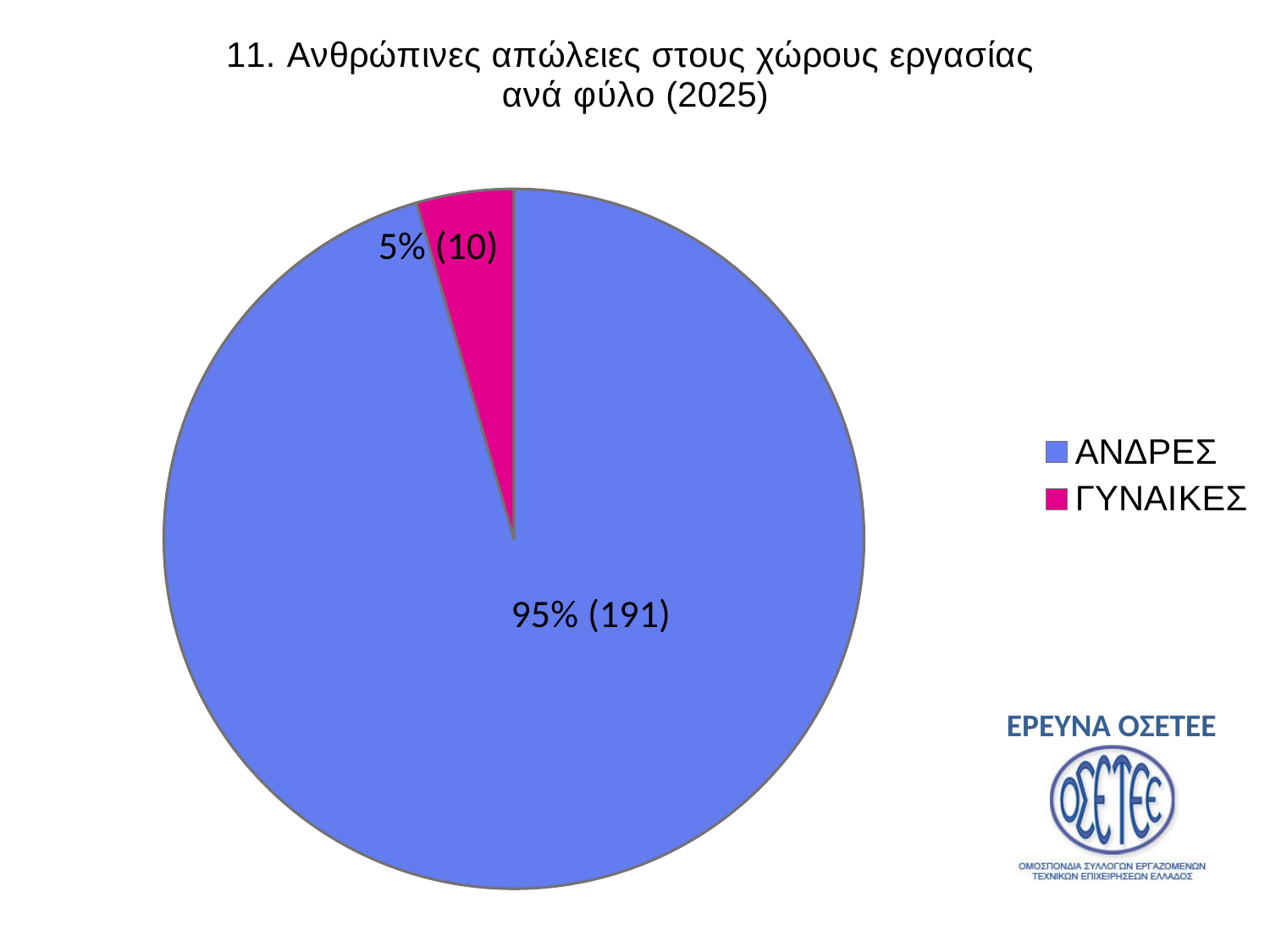
What colour is the slice for ΓΥΝΑΙΚΕΣ? magenta (pink) What share of the pie does ΑΝΔΡΕΣ represent? 95% What is the total of the counts shown on the pie chart? 201 How many categories does the pie chart have? 2 What is the count shown for ΓΥΝΑΙΚΕΣ? 10 What share of the pie does ΓΥΝΑΙΚΕΣ represent? 5% What is the difference between the counts for ΑΝΔΡΕΣ and ΓΥΝΑΙΚΕΣ? 181 Which category has the smallest slice of the pie? ΓΥΝΑΙΚΕΣ What kind of chart is shown on the slide? pie chart What is the count shown for ΑΝΔΡΕΣ? 191 Which category has the largest slice of the pie? ΑΝΔΡΕΣ Which is larger, the count for ΑΝΔΡΕΣ or the count for ΓΥΝΑΙΚΕΣ? ΑΝΔΡΕΣ